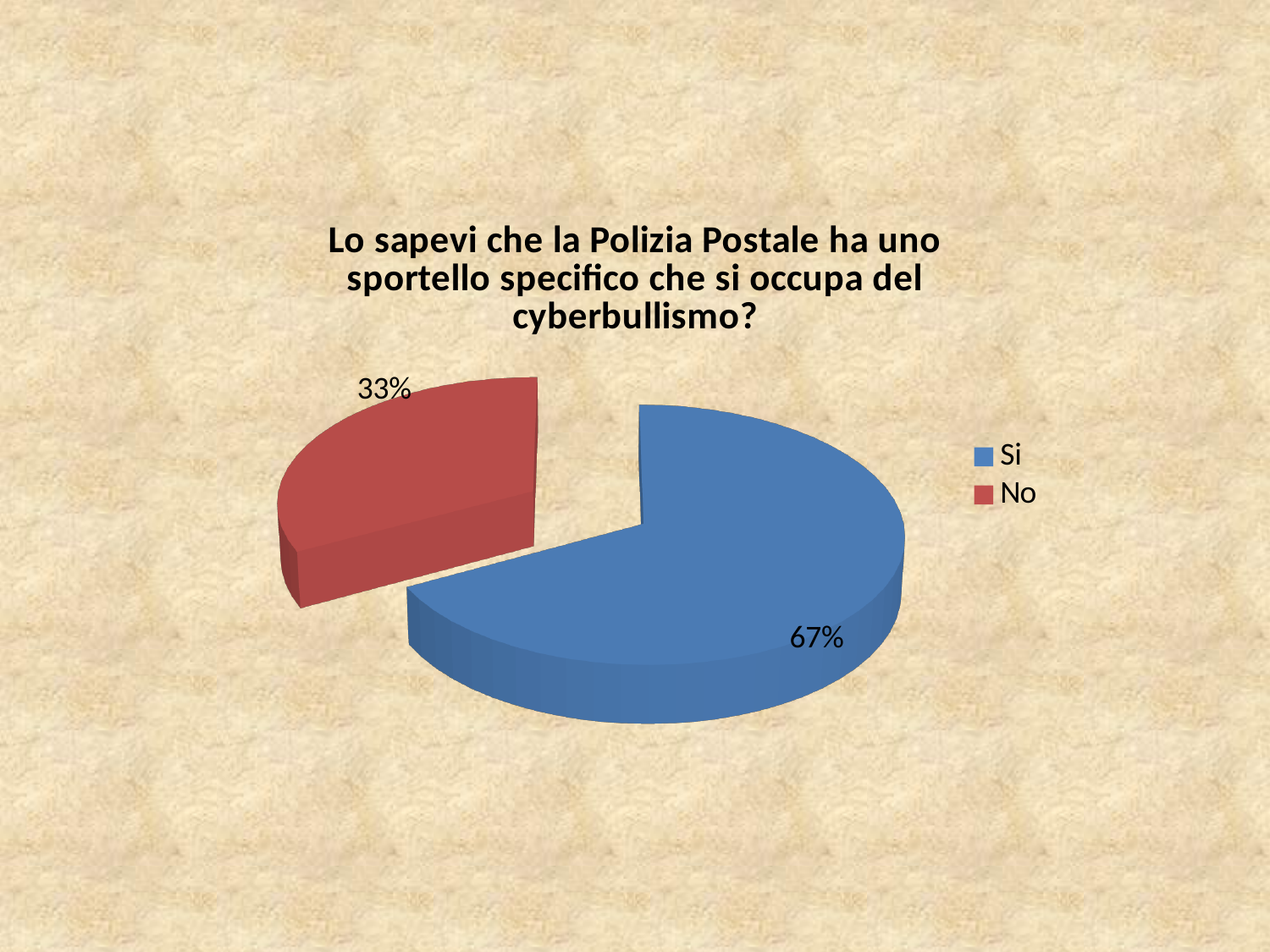
What percentage of respondents answered "Si"? 67% Which is larger, the share for "Si" or the share for "No"? Si Which response has the smallest share of the pie? No What percentage of respondents answered "No"? 33% What share of the pie does the "Si" slice represent? 67% What colour is the "No" slice? red What is the difference in percentage points between the "Si" and "No" slices? 34 What is the title of the chart? Lo sapevi che la Polizia Postale ha uno sportello specifico che si occupa del cyberbullismo? What kind of chart is shown on the slide? pie chart How many entries does the legend list? 2 How many slices does the pie chart have? 2 Which response has the largest share of the pie? Si